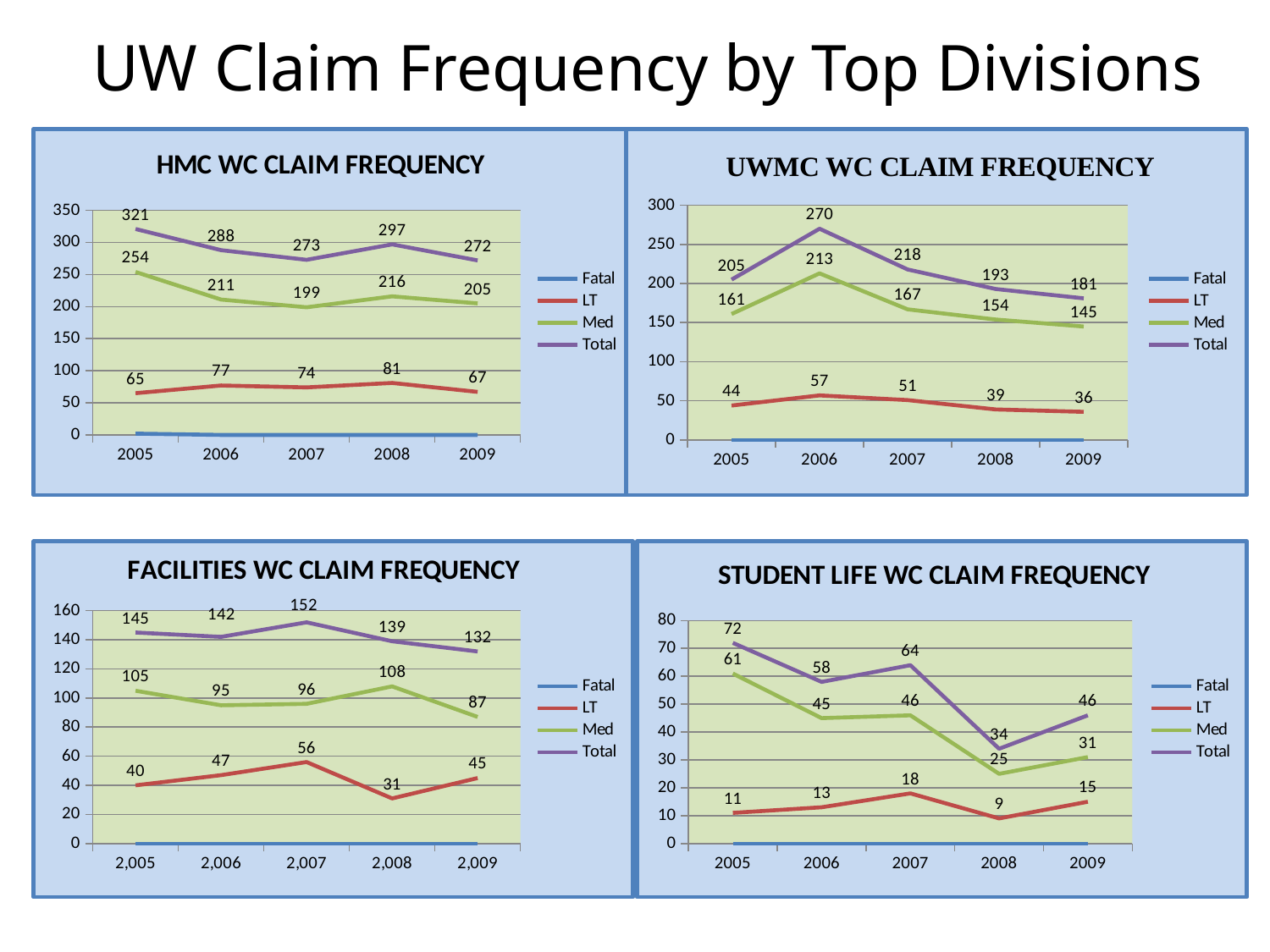
In the UWMC WC CLAIM FREQUENCY chart, is the Med value for 2006 larger or smaller than the Med value for 2009? larger In the STUDENT LIFE WC CLAIM FREQUENCY chart, which year has the lowest Med value? 2008 In the HMC WC CLAIM FREQUENCY chart, what is the Total value for 2005? 321 In the UWMC WC CLAIM FREQUENCY chart, does the Total series rise or fall from 2006 to 2009? fall How many series does the legend list in the FACILITIES WC CLAIM FREQUENCY chart? 4 How many years are shown on the x axis of the HMC WC CLAIM FREQUENCY chart? 5 In the UWMC WC CLAIM FREQUENCY chart, which year has the highest Total value? 2006 How many charts are shown on the slide? 4 In the STUDENT LIFE WC CLAIM FREQUENCY chart, what is the difference between the Total and Med values for 2007? 18 In the HMC WC CLAIM FREQUENCY chart, what is the difference between the Total values for 2005 and 2009? 49 What kind of chart is the STUDENT LIFE WC CLAIM FREQUENCY chart? line chart In the FACILITIES WC CLAIM FREQUENCY chart, what is the LT value for 2008? 31